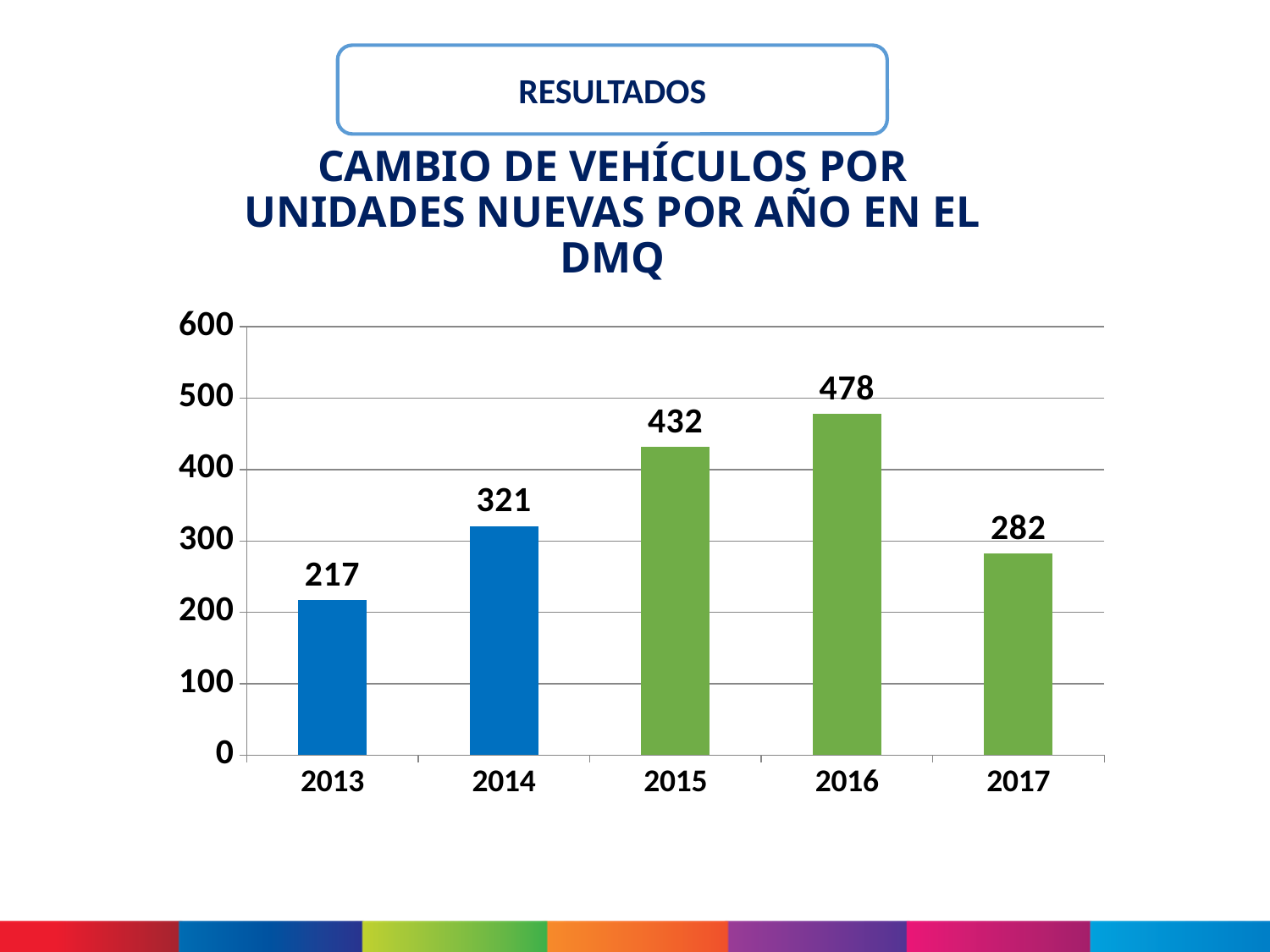
What is the difference between the values for 2016 and 2015? 46 Which year has the highest value? 2016 What colour are the bars for 2015, 2016 and 2017? green How many years are shown on the x axis? 5 What is the difference between the values for 2014 and 2013? 104 Is the value for 2014 greater or less than 300? greater What is the value for 2017? 282 What is the value for 2013? 217 Which is larger, the value for 2015 or the value for 2017? 2015 What is the value for 2016? 478 Which year has the lowest value? 2013 What kind of chart is shown on the slide? bar chart